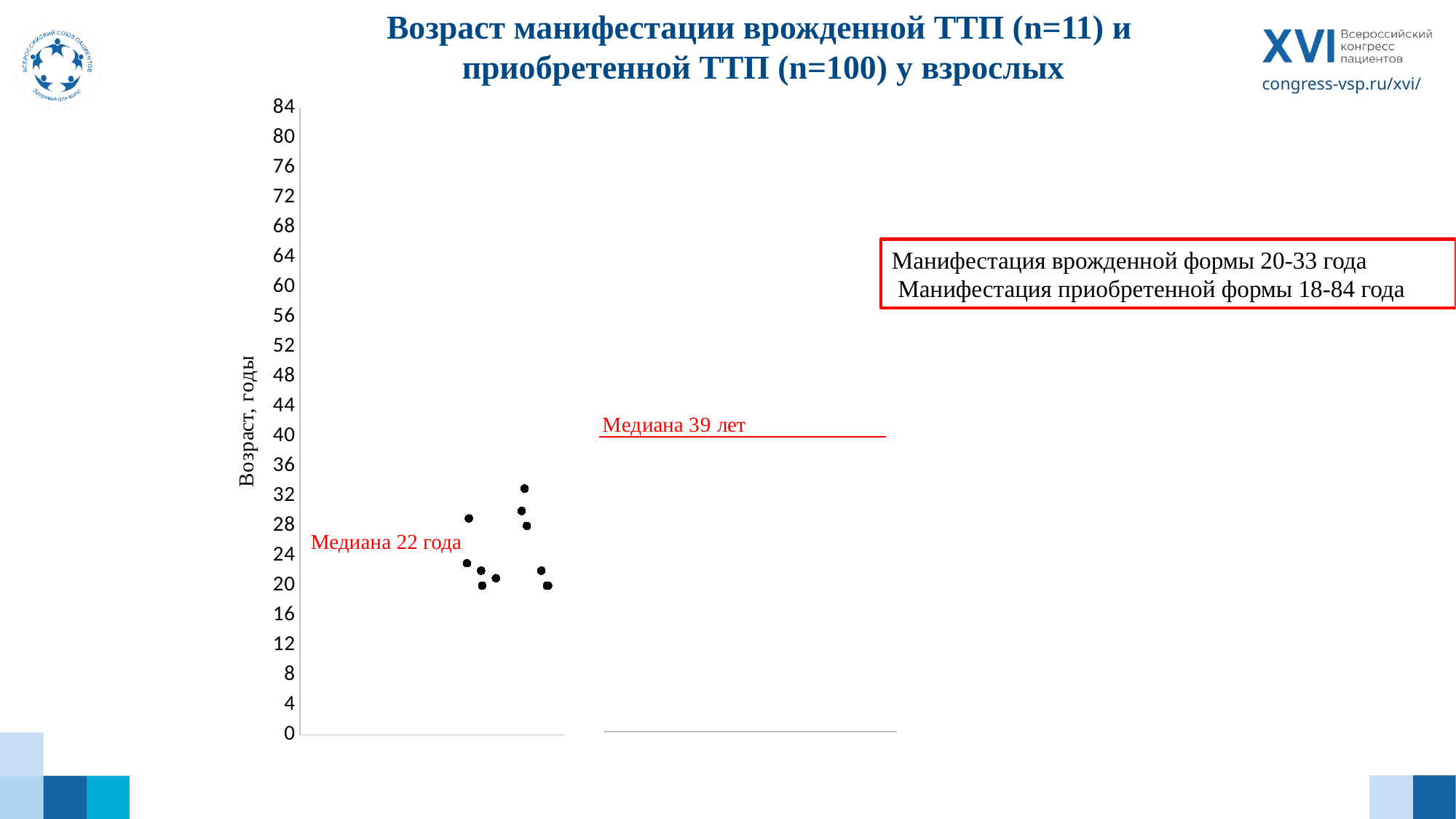
What is the highest value shown on the vertical axis of the chart? 84 What is the median age of manifestation annotated for the acquired (приобретенная) form on the chart? 39 лет How many data points are plotted on the chart? 11 Is the highest plotted point on the chart greater or less than 36 on the vertical axis? less Is the lowest plotted point on the chart greater or less than 16 on the vertical axis? greater Which annotated median is larger: 'Медиана 22 года' or 'Медиана 39 лет'? Медиана 39 лет What kind of chart is shown on the slide? scatter plot What is the difference between the two annotated medians, 39 лет and 22 года? 17 What is the label of the vertical axis of the chart? Возраст, годы What is the median age of manifestation annotated for the congenital (врожденная) form on the chart? 22 года What is the title of the chart on the slide? Возраст манифестации врожденной ТТП (n=11) и приобретенной ТТП (n=100) у взрослых According to the text box on the slide, what is the age range of manifestation for the acquired (приобретенная) form? 18-84 года